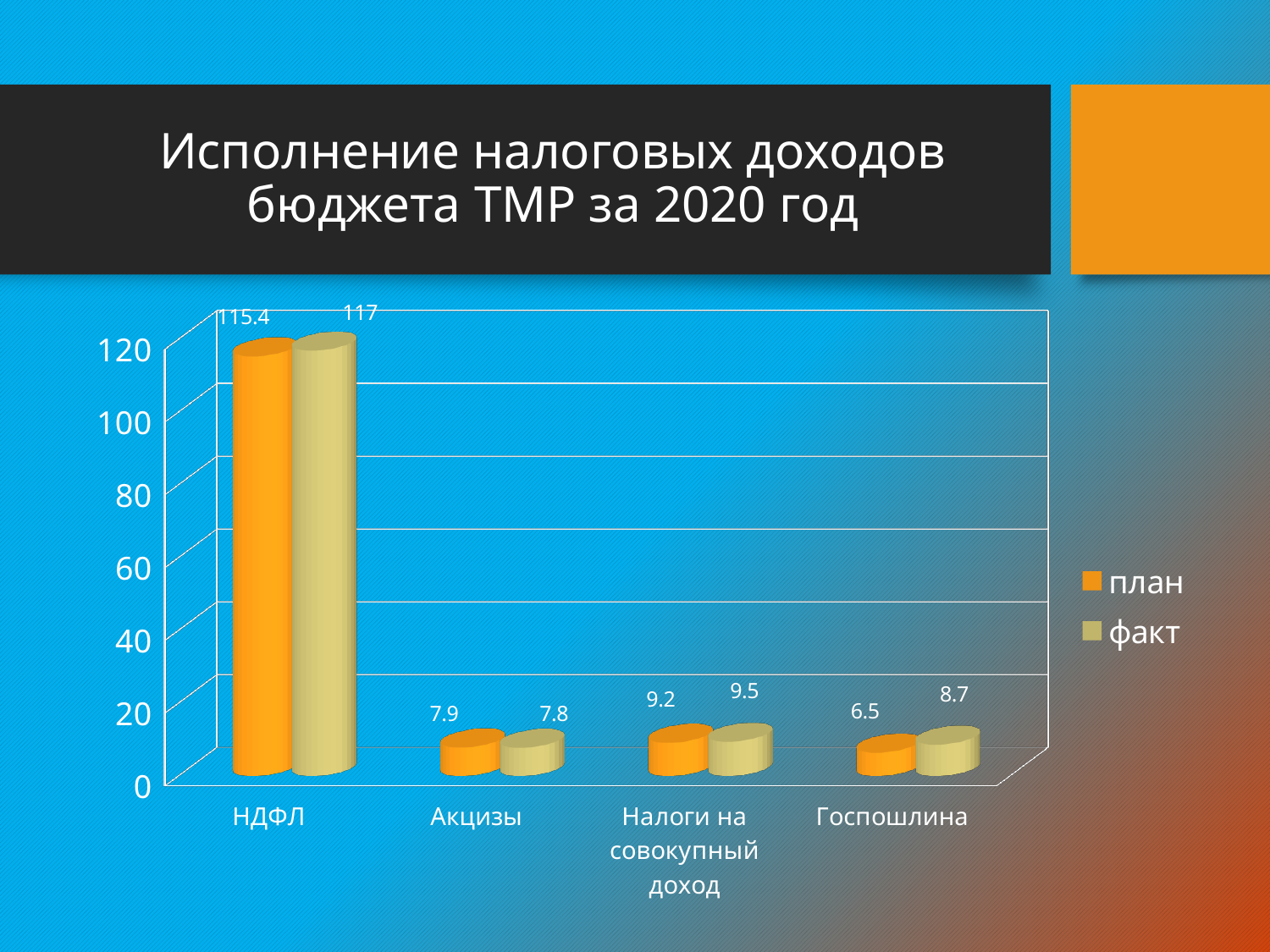
Is the факт value for НДФЛ greater or less than 100? greater How many categories are shown on the x axis? 4 Which category has the highest факт value? НДФЛ What is the difference between the факт and план values for НДФЛ? 1.6 What kind of chart is shown on the slide? bar chart What is the план value for НДФЛ? 115.4 What is the difference between the факт and план values for Госпошлина? 2.2 Which is larger for Акцизы, план or факт? план What is the план value for Госпошлина? 6.5 Which category has the lowest план value? Госпошлина What is the факт value for Налоги на совокупный доход? 9.5 How many series does the legend list? 2